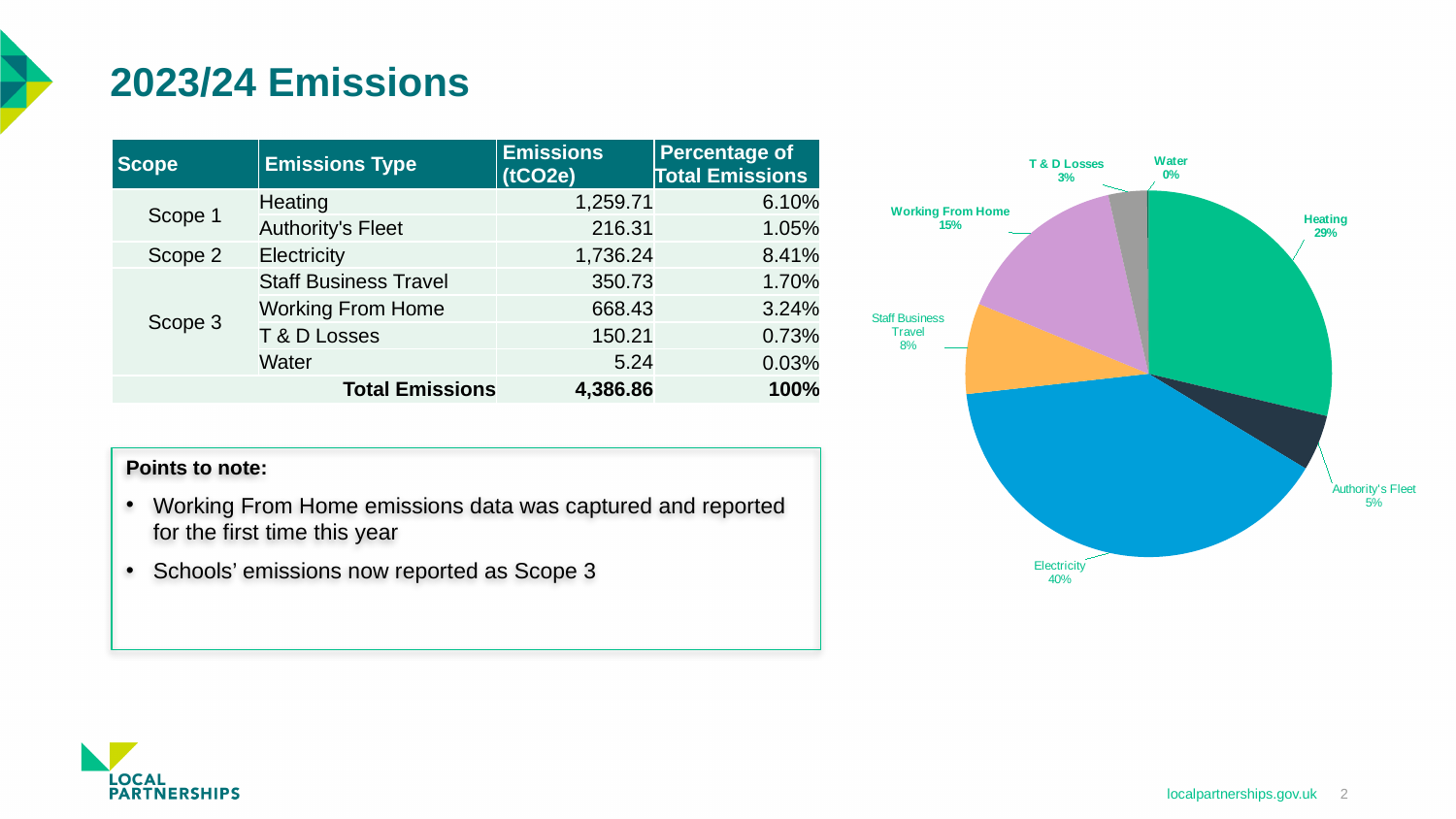
In the pie chart, what share does Authority's Fleet have? 5% In the pie chart, what share does Electricity have? 40% What kind of chart is shown on the slide? Pie chart In the pie chart, what is the difference in percentage points between Electricity and Heating? 11 percentage points Which slice of the pie chart is the largest? Electricity Which slice of the pie chart is the smallest? Water In the pie chart, which is larger: Heating or Working From Home? Heating In the pie chart, what share does Heating have? 29% How many slices does the pie chart have? 7